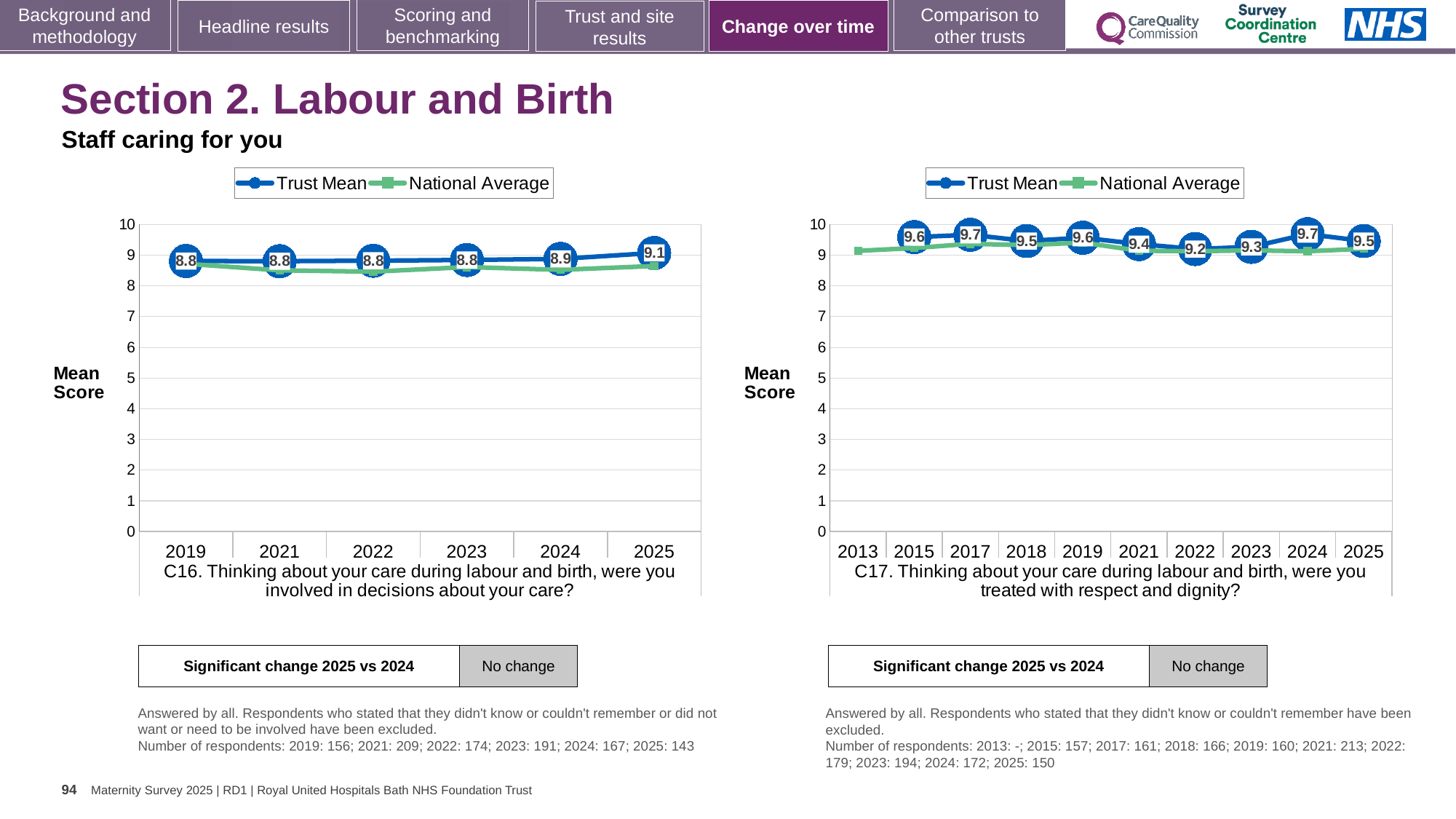
In the C16 chart (left), which year has the highest Trust Mean score? 2025 In the C17 chart (right), what is the difference between the Trust Mean scores for 2024 and 2025? 0.2 How many years are shown on the x axis of the C17 chart (right)? 10 In the C16 chart (left), what is the Trust Mean score for 2025? 9.1 What type of chart is the C16 chart (left)? Line chart In the C17 chart (right), which year has the lowest Trust Mean score? 2022 How many series does the legend of the C16 chart (left) list? 2 In the C17 chart (right), what is the Trust Mean score for 2024? 9.7 In the C17 chart (right), what is the Trust Mean score for 2022? 9.2 In the C17 chart (right), is the National Average value for 2013 greater or less than 8? greater In the C16 chart (left), what is the Trust Mean score for 2019? 8.8 In the C16 chart (left), is the Trust Mean score for 2024 larger or smaller than the score for 2025? smaller